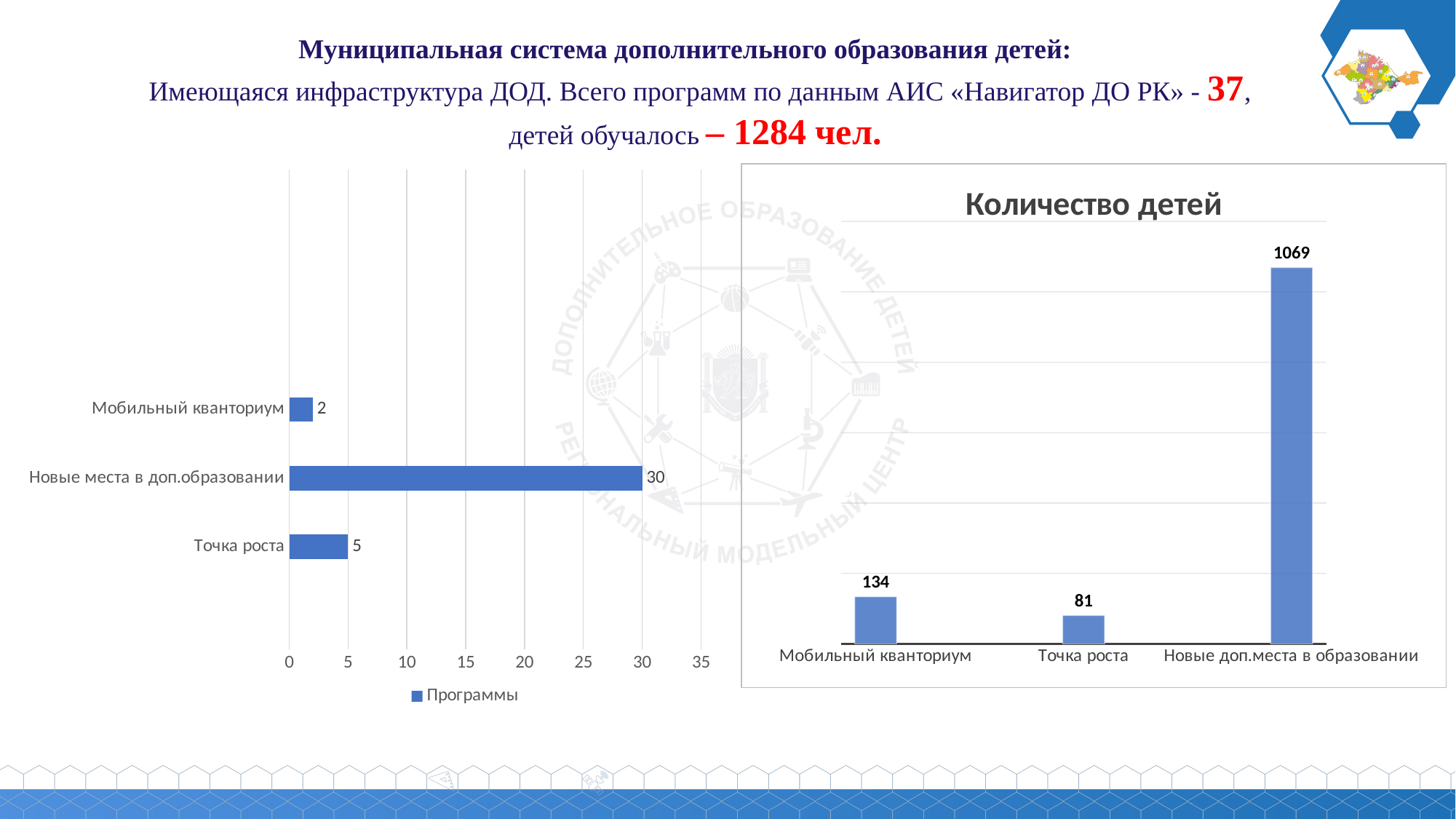
In the chart titled Количество детей, which is larger: Мобильный кванториум or Точка роста? Мобильный кванториум In the left chart, what is the value for Мобильный кванториум? 2 In the left chart, what is the difference between Новые места в доп.образовании and Точка роста? 25 In the chart titled Количество детей, what is the value for Новые доп.места в образовании? 1069 In the left chart, which category has the lowest value? Мобильный кванториум How many categories are shown in the chart titled Количество детей? 3 In the left chart, what series name does the legend show? Программы In the chart titled Количество детей, what is the value for Точка роста? 81 In the left chart, what is the value for Новые места в доп.образовании? 30 In the chart titled Количество детей, what is the difference between Мобильный кванториум and Точка роста? 53 In the chart titled Количество детей, which category has the highest value? Новые доп.места в образовании What kind of chart is the left chart? bar chart